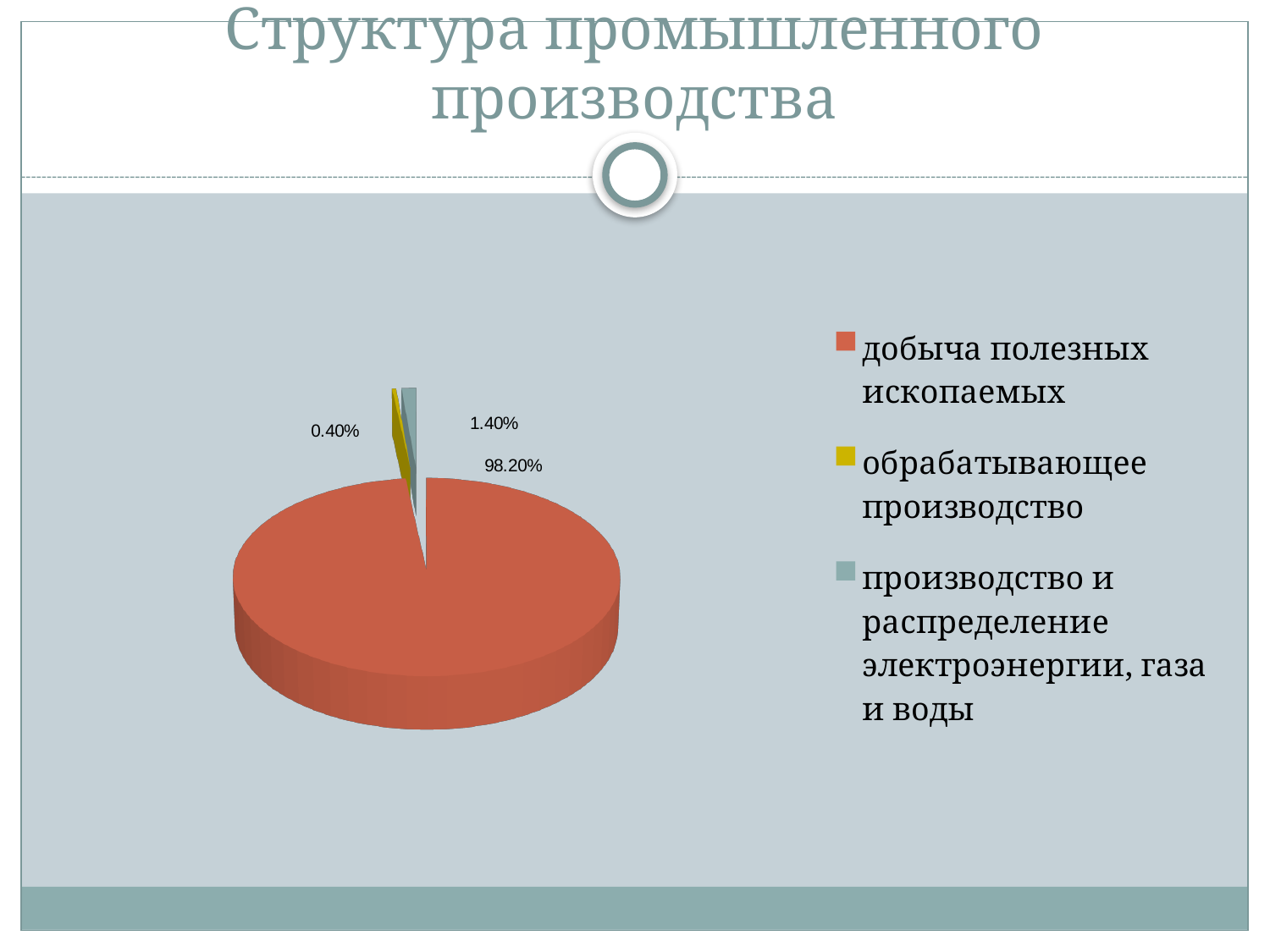
Which category has the largest slice of the pie? добыча полезных ископаемых Which category has the smallest slice of the pie? обрабатывающее производство What share of the pie does "производство и распределение электроэнергии, газа и воды" have? 1.40% What is the difference between the share of "добыча полезных ископаемых" and the share of "производство и распределение электроэнергии, газа и воды"? 96.80% What is the difference between the share of "производство и распределение электроэнергии, газа и воды" and the share of "обрабатывающее производство"? 1.00% What is the title of the slide containing the pie chart? Структура промышленного производства How many categories does the pie chart show? 3 Which is larger: the share of "обрабатывающее производство" or the share of "производство и распределение электроэнергии, газа и воды"? производство и распределение электроэнергии, газа и воды What kind of chart is shown on the slide? pie chart What colour is the slice for "обрабатывающее производство"? yellow What share of the pie does "обрабатывающее производство" have? 0.40% What share of the pie does "добыча полезных ископаемых" have? 98.20%